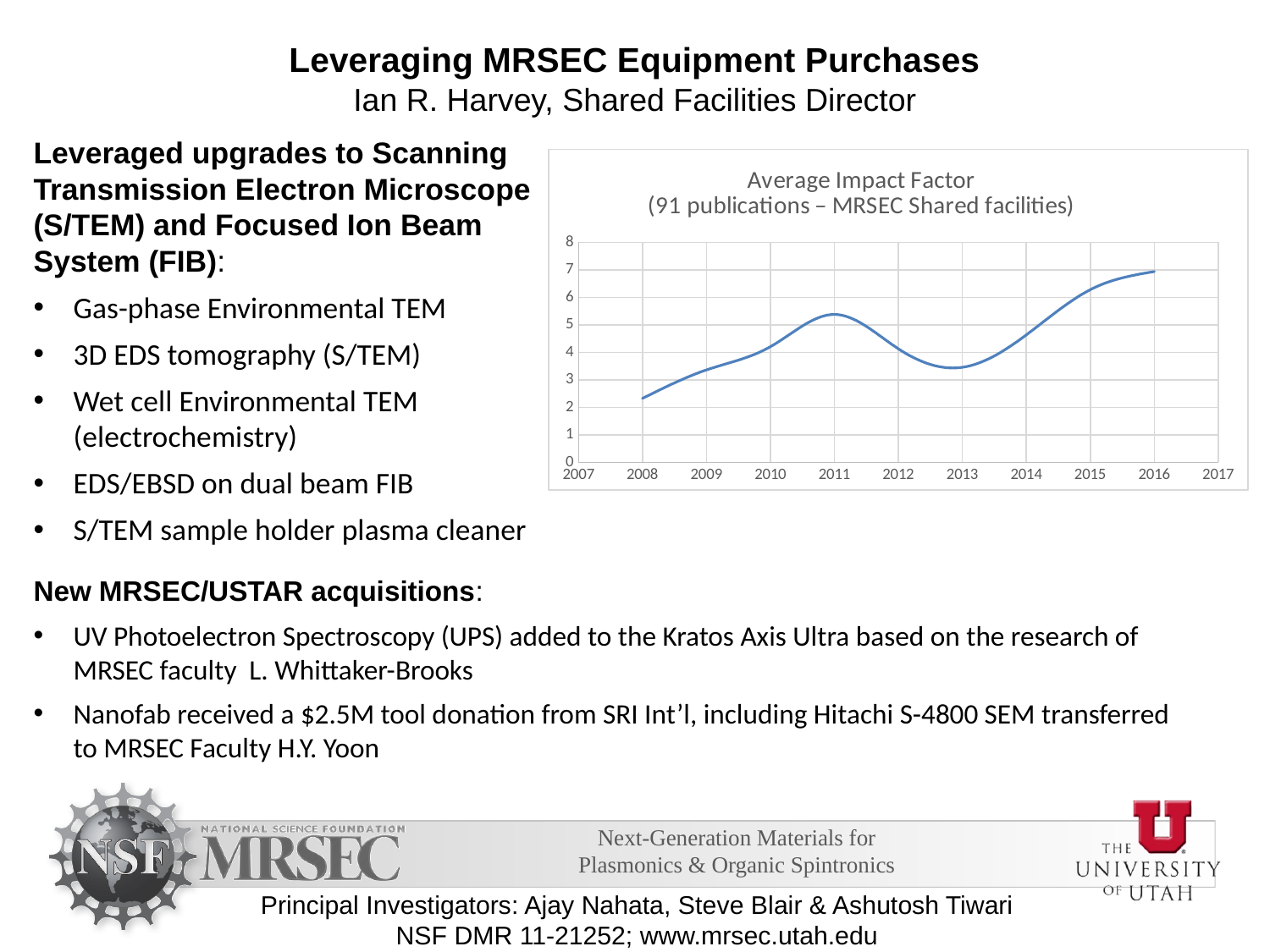
How many publications does the chart title say the average impact factor is based on? 91 Is the average impact factor for 2016 greater or less than 6? greater Which year has the lowest average impact factor? 2008 Does the average impact factor rise or fall between 2013 and 2016? rise What kind of chart is shown on the slide? line chart Does the average impact factor rise or fall between 2011 and 2013? fall Which year has a higher average impact factor, 2011 or 2013? 2011 Is the average impact factor for 2008 greater or less than 3? less Which year has the highest average impact factor? 2016 Is the average impact factor for 2013 greater or less than 4? less What is the title of the chart? Average Impact Factor (91 publications – MRSEC Shared facilities)